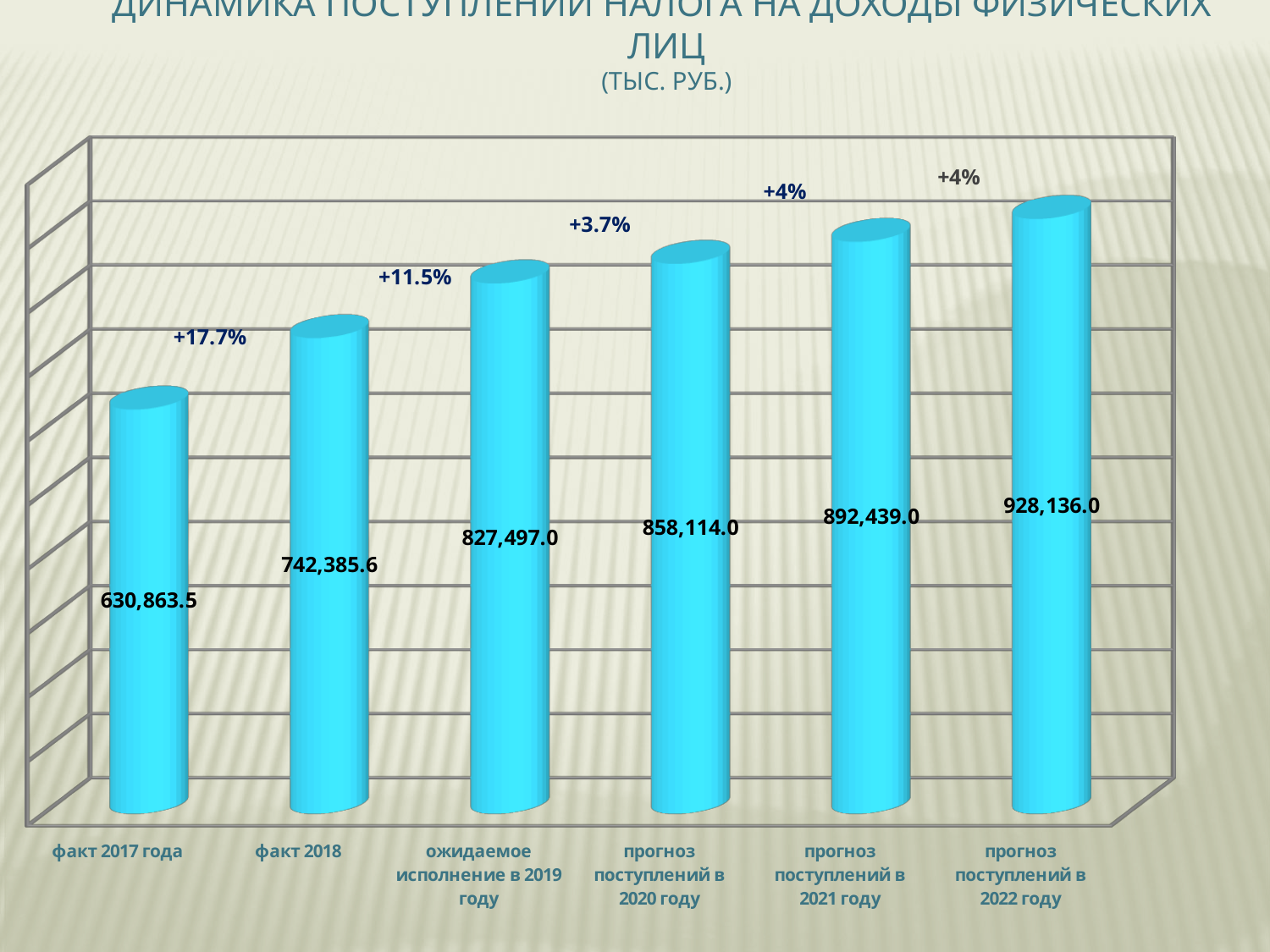
What is the value for ожидаемое исполнение в 2019 году? 827,497.0 What is the value for факт 2018? 742,385.6 How many categories are shown on the chart? 6 Do the values rise or fall from факт 2017 года to прогноз поступлений в 2022 году? rise Which category has the lowest value? факт 2017 года Which is larger, the value for прогноз поступлений в 2021 году or the value for факт 2018? прогноз поступлений в 2021 году What is the difference between the values for прогноз поступлений в 2022 году and факт 2017 года? 297,272.5 What kind of chart is shown on the slide? bar chart What is the value for прогноз поступлений в 2022 году? 928,136.0 What is the value for факт 2017 года? 630,863.5 Which category has the highest value? прогноз поступлений в 2022 году What is the difference between the values for прогноз поступлений в 2020 году and ожидаемое исполнение в 2019 году? 30,617.0